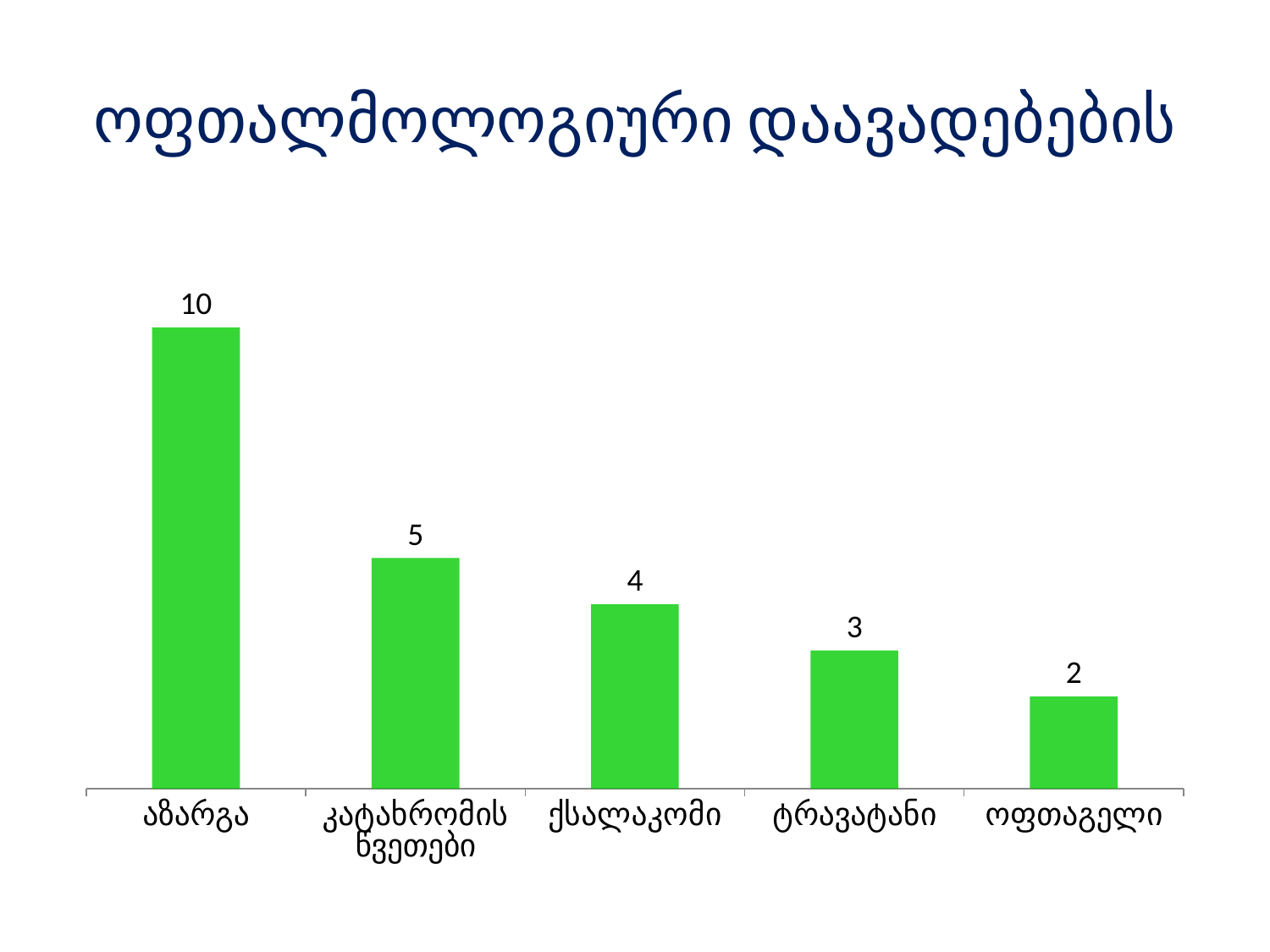
What kind of chart is shown on the slide? Bar chart What is the value for ქსალაკომი? 4 Which category has the highest value? აზარგა What is the value for აზარგა? 10 What is the value for ტრავატანი? 3 Which is larger, the value for ქსალაკომი or the value for ტრავატანი? ქსალაკომი Do the values rise or fall from left to right along the x axis? Fall What is the title of the slide? ოფთალმოლოგიური დაავადებების What is the value for ოფთაგელი? 2 How many categories are shown in the chart? 5 Which category has the lowest value? ოფთაგელი